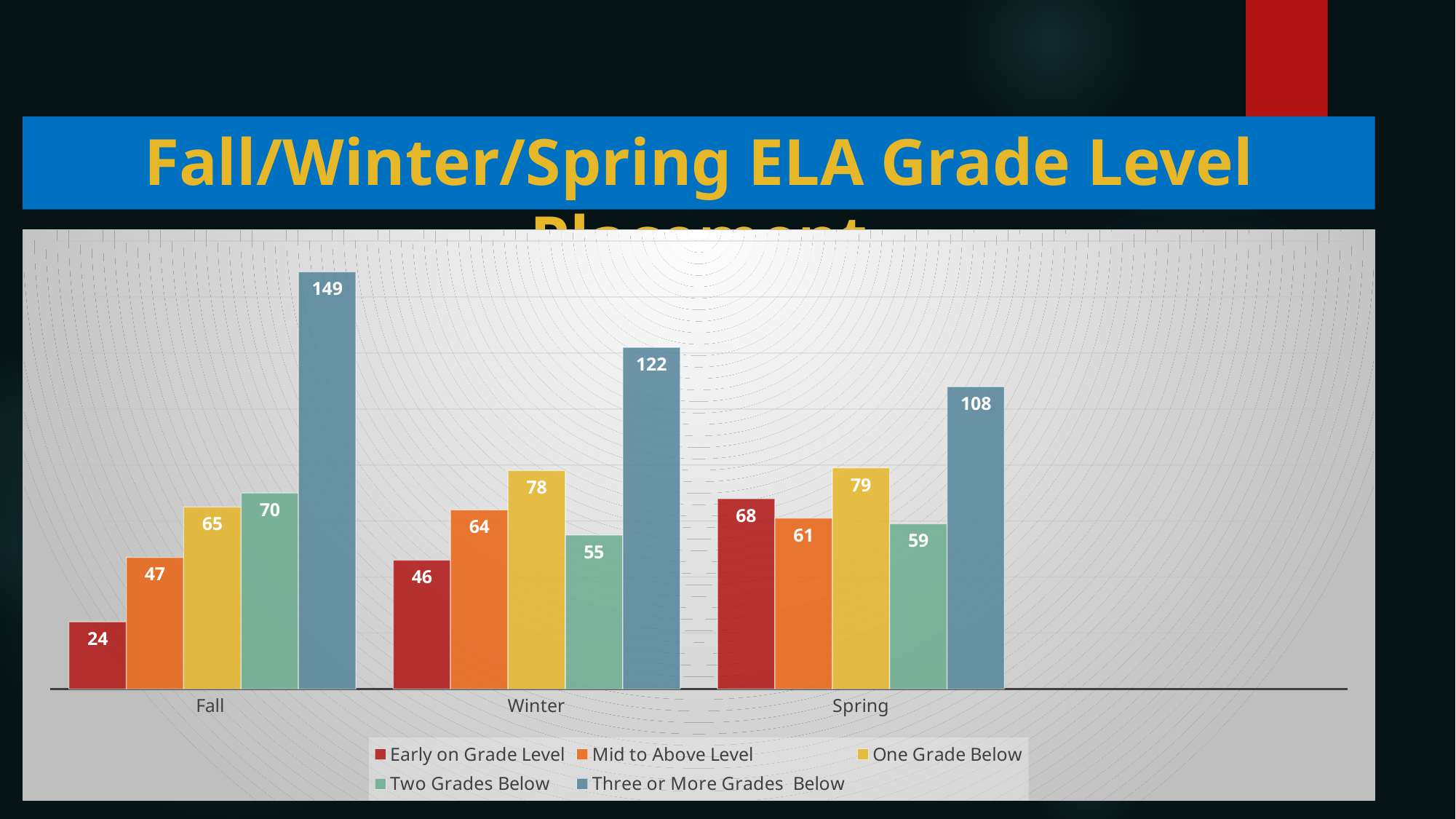
What is the value for Three or More Grades Below in Fall? 149 Does the Three or More Grades Below value rise or fall from Fall to Spring? Fall What colour are the bars for Two Grades Below? Green What is the value for Early on Grade Level in Spring? 68 What kind of chart is shown on the slide? Bar chart What is the value for One Grade Below in Winter? 78 How many series does the legend list? 5 Which series has the highest value in Winter? Three or More Grades Below Which series has the lowest value in Fall? Early on Grade Level What is the difference between the Three or More Grades Below values for Fall and Spring? 41 Which is larger: Mid to Above Level in Winter or Mid to Above Level in Fall? Mid to Above Level in Winter How many categories are shown on the x axis? 3